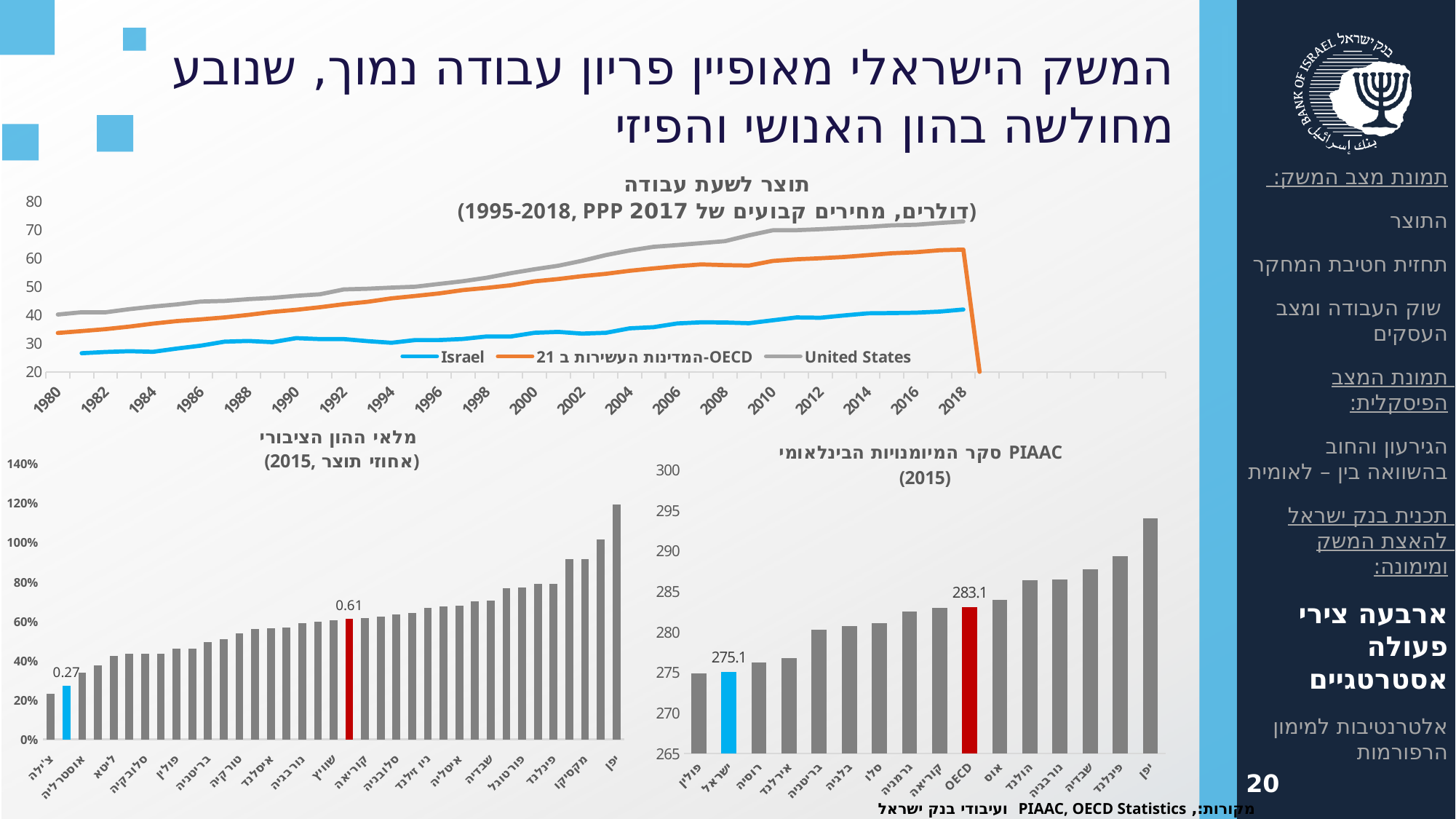
In the top chart 'תוצר לשעת עבודה', which series has the lowest values across the whole period? Israel In the top chart 'תוצר לשעת עבודה', do the values for Israel rise or fall from 1980 to 2018? rise In the bottom-left chart 'מלאי ההון הציבורי', what is the difference between the value of the red bar (0.61) and the blue bar (0.27)? 0.34 In the bottom-right chart 'PIAAC סקר המיומנויות הבינלאומי (2015)', what is the value for OECD? 283.1 How many series does the legend of the top chart 'תוצר לשעת עבודה' list? 3 In the bottom-right chart 'PIAAC סקר המיומנויות הבינלאומי (2015)', what is the value for ישראל? 275.1 What type of chart is the top chart titled 'תוצר לשעת עבודה'? line chart In the bottom-right chart 'PIAAC סקר המיומנויות הבינלאומי (2015)', which country has the highest value? יפן In the top chart 'תוצר לשעת עבודה', which series has the highest values across the whole period? United States In the top chart 'תוצר לשעת עבודה', is the value for United States in 2018 greater or less than 70? greater In the bottom-right chart 'PIAAC סקר המיומנויות הבינלאומי (2015)', what is the difference between the OECD value and the ישראל value? 8.0